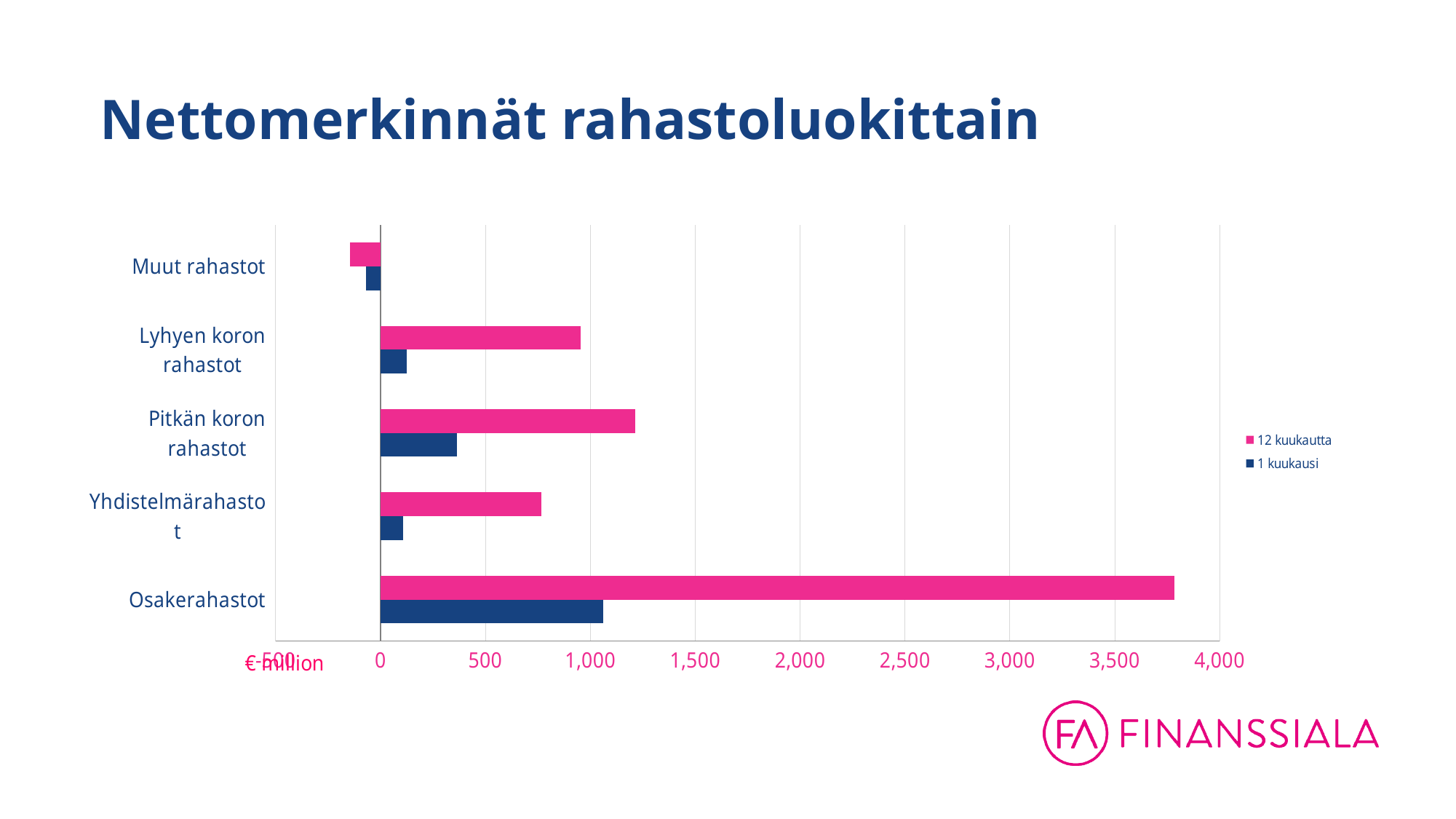
Which is larger for Pitkän koron rahastot: the 12 kuukautta value or the 1 kuukausi value? 12 kuukautta Is the 12 kuukautta value for Osakerahastot greater or less than 3,500? greater Which category has the lowest value for the 12 kuukautta series? Muut rahastot Is the 12 kuukautta value for Lyhyen koron rahastot greater or less than 1,000? less Which category has the highest value for the 12 kuukautta series? Osakerahastot How many fund categories are shown on the chart? 5 What kind of chart is shown on the slide? Bar chart Is the 1 kuukausi value for Osakerahastot greater or less than 1,000? greater How many series does the legend list? 2 What is the title of the chart on the slide? Nettomerkinnät rahastoluokittain Which category has the highest value for the 1 kuukausi series? Osakerahastot